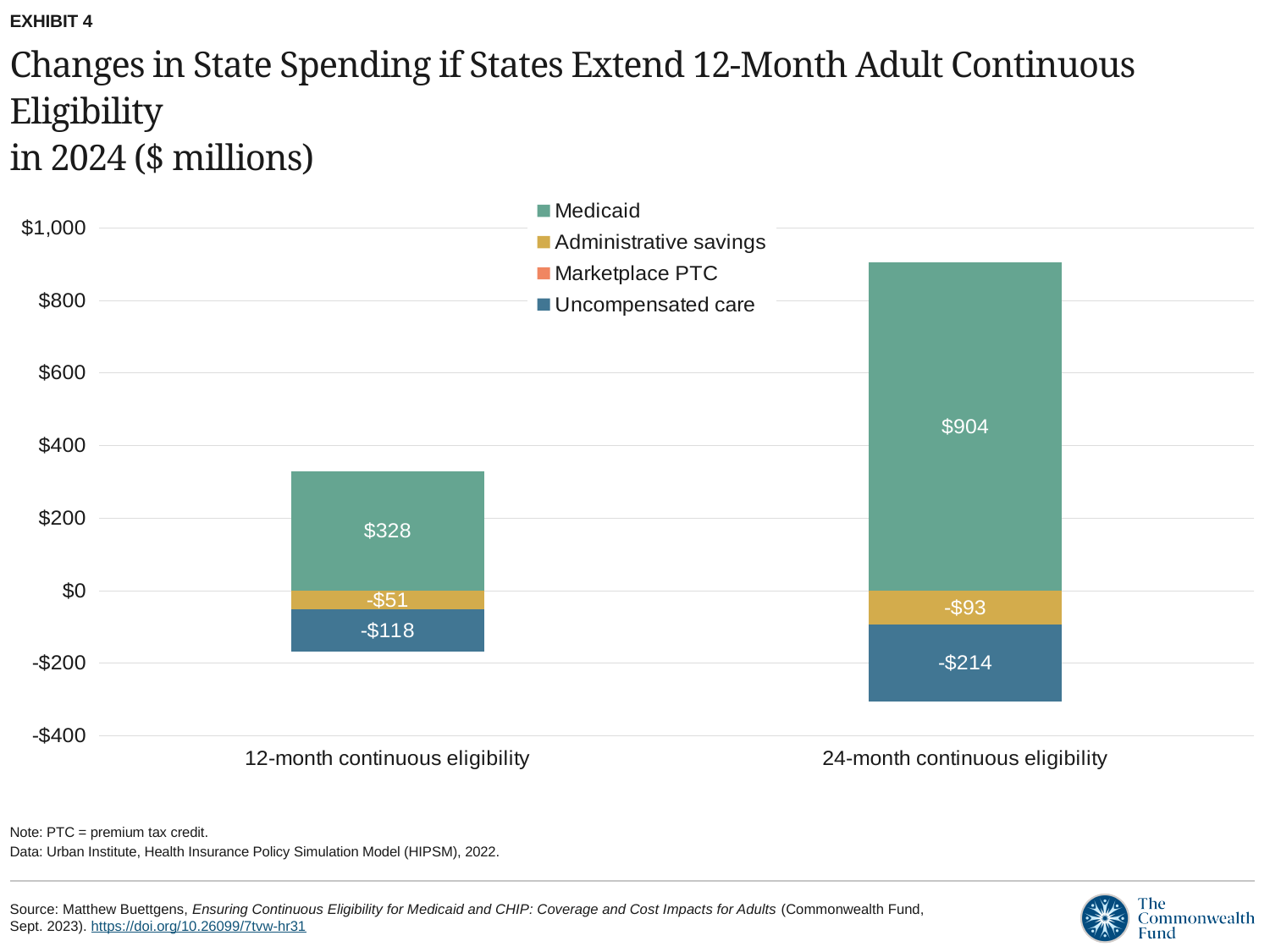
What is the Medicaid value for 24-month continuous eligibility? $904 What is the Medicaid value for 12-month continuous eligibility? $328 What is the Administrative savings value for 12-month continuous eligibility? -$51 What kind of chart is shown on the slide? Stacked bar chart How many series does the legend list? 4 Which series is shown in green in the legend? Medicaid How many categories are shown on the x axis? 2 What is the Administrative savings value for 24-month continuous eligibility? -$93 Which category has the larger Medicaid value, 12-month or 24-month continuous eligibility? 24-month continuous eligibility What is the Uncompensated care value for 12-month continuous eligibility? -$118 What is the Uncompensated care value for 24-month continuous eligibility? -$214 How much larger is the Medicaid value for 24-month continuous eligibility than for 12-month continuous eligibility? $576